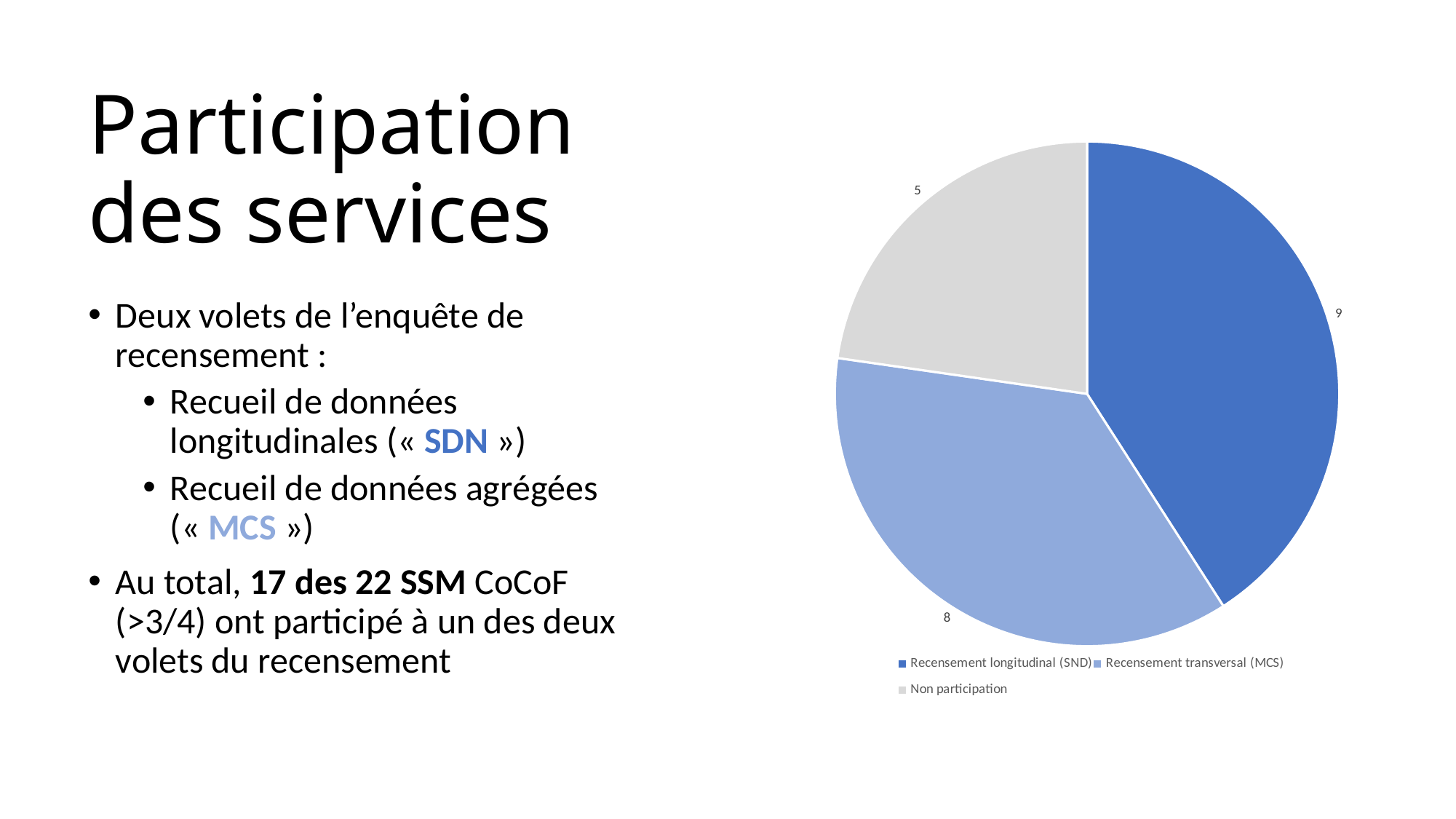
What type of chart is shown on the slide? Pie chart What is the value for Recensement transversal (MCS) in the pie chart? 8 Which category has the largest slice in the pie chart? Recensement longitudinal (SND) Which category has the smallest slice in the pie chart? Non participation How many slices does the pie chart have? 3 What is the total of all the slices in the pie chart? 22 What is the value for Non participation in the pie chart? 5 What colour is the Non participation slice in the pie chart? Grey Which is larger: the value for Recensement transversal (MCS) or the value for Non participation? Recensement transversal (MCS) What is the difference between the values for Recensement longitudinal (SND) and Non participation? 4 What is the value for Recensement longitudinal (SND) in the pie chart? 9 What is the difference between the values for Recensement longitudinal (SND) and Recensement transversal (MCS)? 1